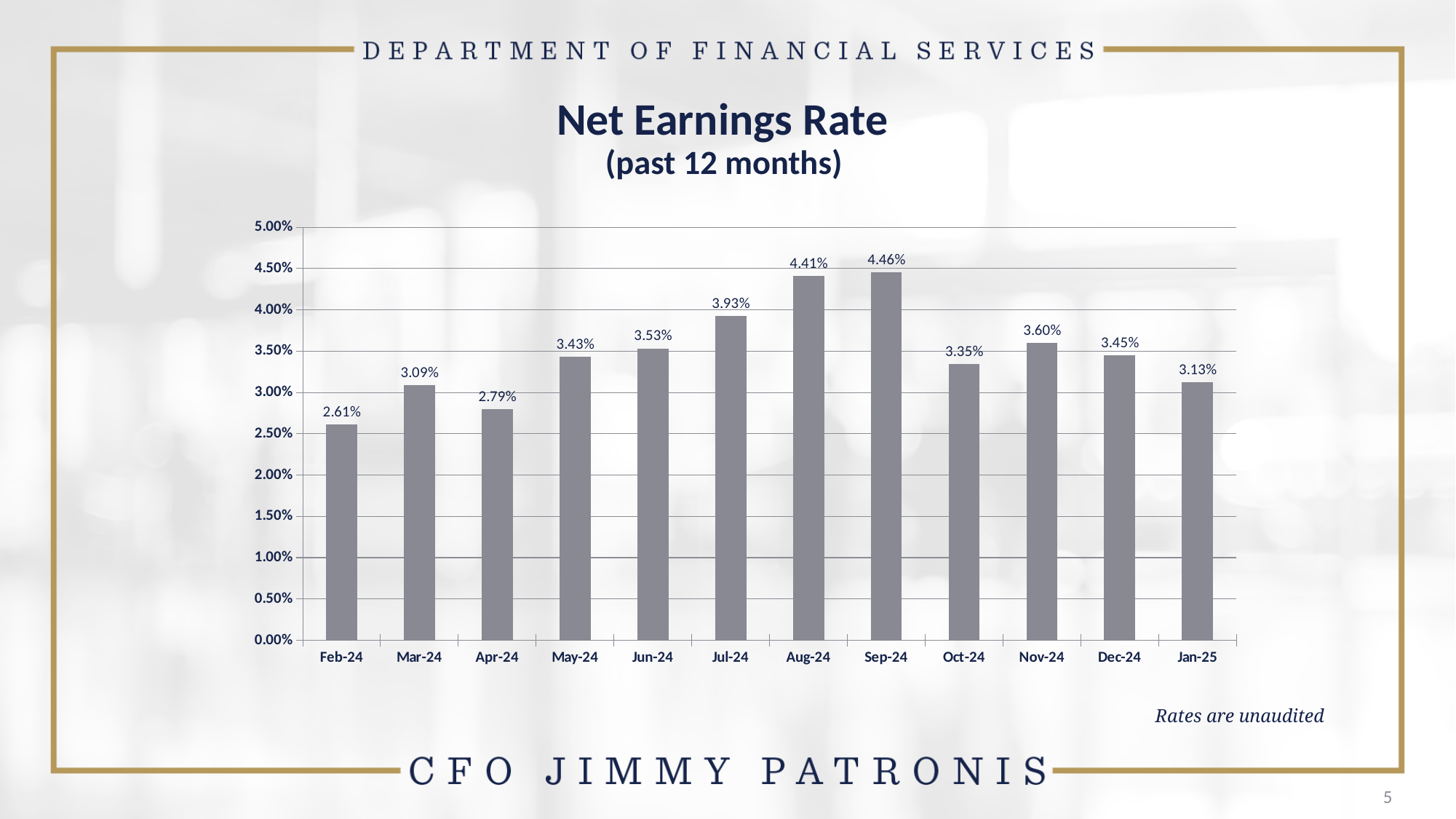
Is the net earnings rate for Jul-24 greater or less than 3.50%? greater What is the net earnings rate for Feb-24? 2.61% Which month has the lowest net earnings rate? Feb-24 Which month has the highest net earnings rate? Sep-24 How many months are shown on the chart? 12 What is the net earnings rate for Sep-24? 4.46% What is the net earnings rate for Jan-25? 3.13% What is the difference between the net earnings rate in Aug-24 and Jul-24? 0.48% Which is larger, the net earnings rate for Nov-24 or Dec-24? Nov-24 What kind of chart is shown on the slide? Bar chart Does the net earnings rate rise or fall from Sep-24 to Oct-24? Fall What is the difference between the net earnings rate in Sep-24 and Feb-24? 1.85%